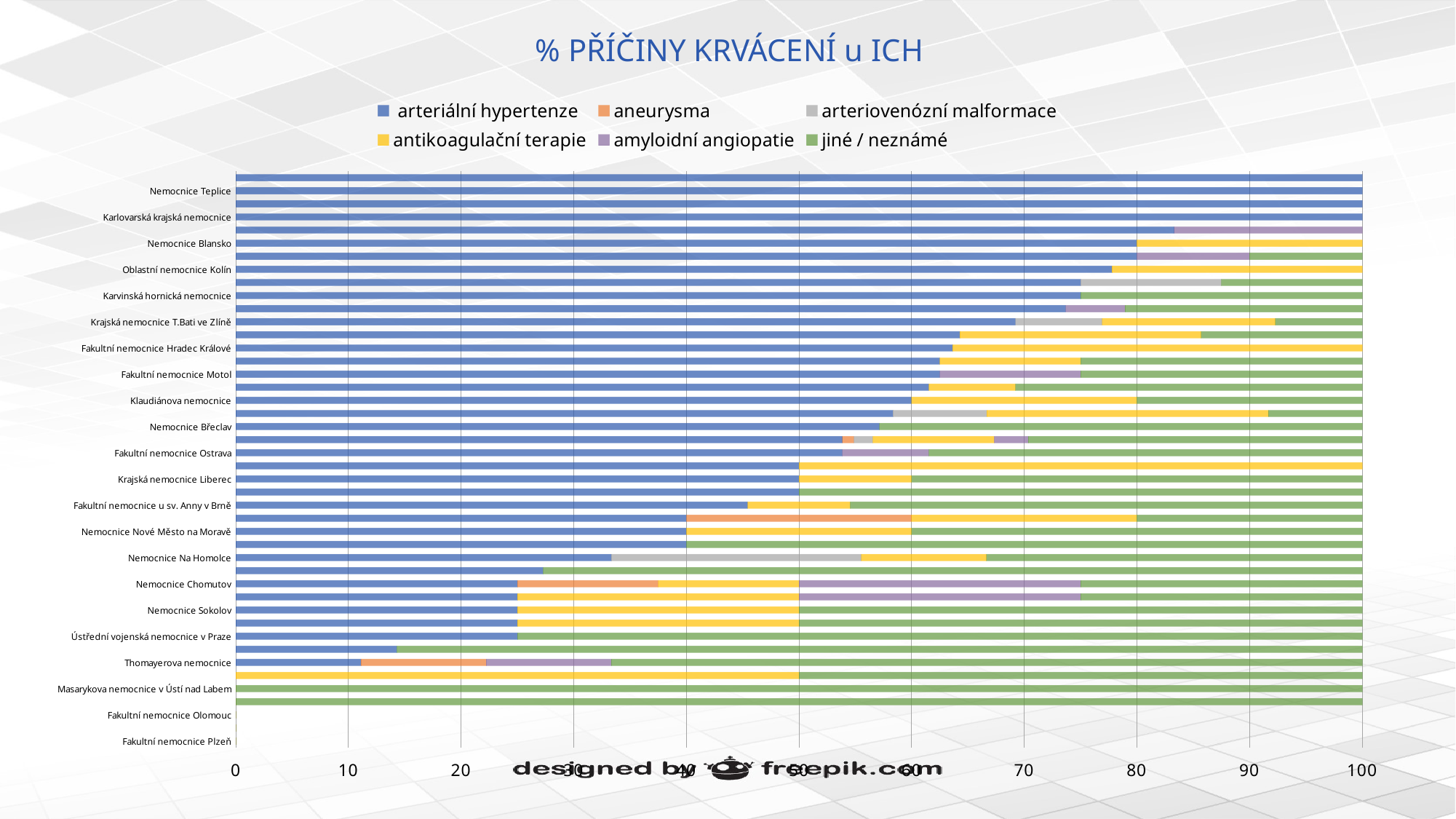
Is the value of arteriální hypertenze for Nemocnice Chomutov greater or less than 30? less Is the value of arteriální hypertenze for Karlovarská krajská nemocnice greater or less than 80? greater Is the value of arteriální hypertenze for Nemocnice Teplice greater or less than 90? greater Which series is shown in blue in the legend? arteriální hypertenze Which has the larger value of arteriální hypertenze, Nemocnice Teplice or Thomayerova nemocnice? Nemocnice Teplice What is the title of the chart? % PŘÍČINY KRVÁCENÍ u ICH How many series does the legend list? 6 What kind of chart is shown on the slide? bar chart